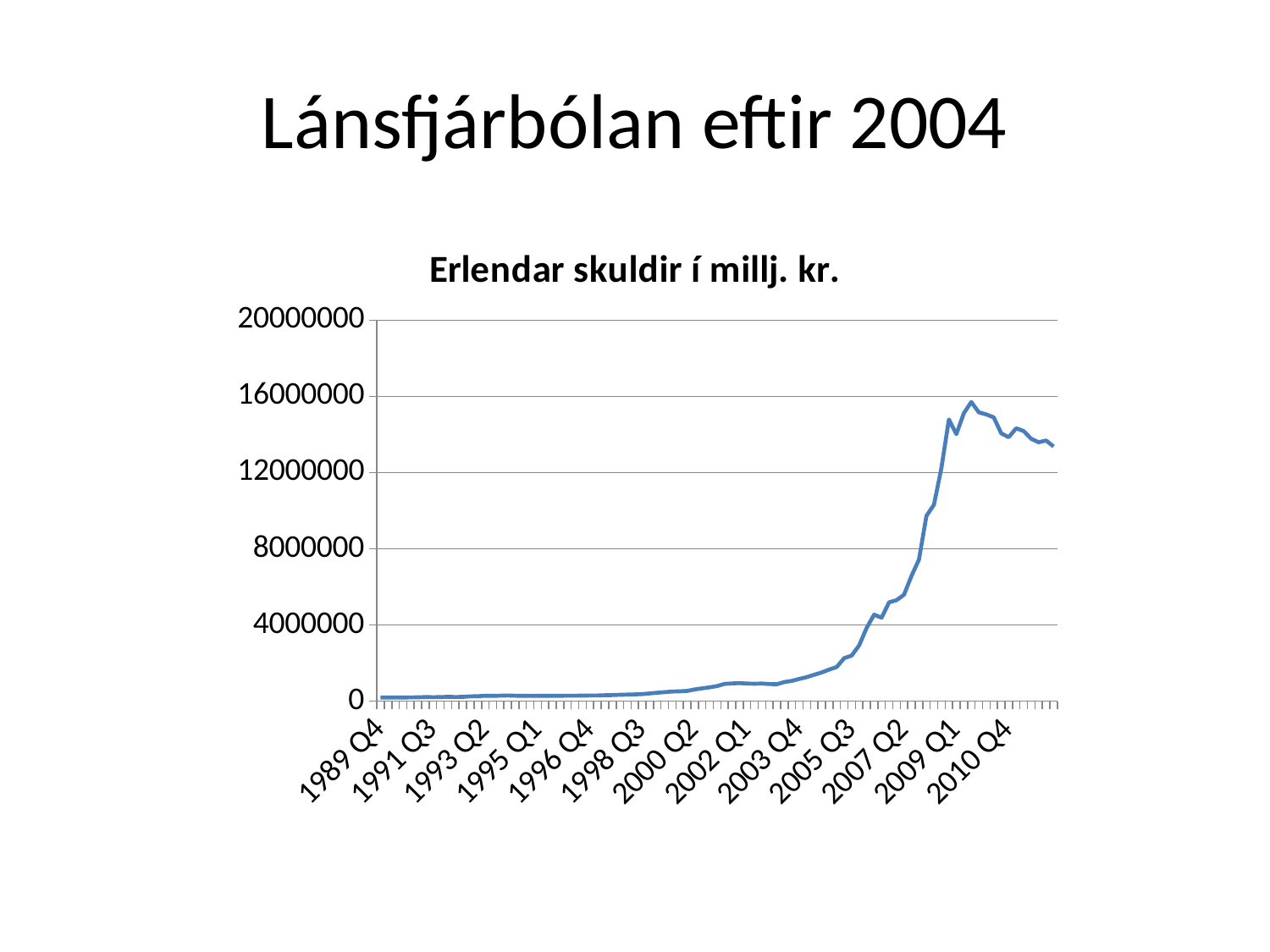
What is the title of the chart? Erlendar skuldir í millj. kr. Is the value at 2007 Q2 greater or less than 8000000? less What is the highest value shown on the y axis? 20000000 Is the value at 2009 Q1 greater or less than 12000000? greater What kind of chart is shown on the slide? line chart Is the value at 2010 Q4 greater or less than 12000000? greater Which is larger, the value at 2009 Q1 or the value at 2007 Q2? 2009 Q1 Overall, do the values rise or fall from 1989 Q4 to 2009 Q1? rise Do the values rise or fall between 2009 Q1 and 2010 Q4 after the peak? fall